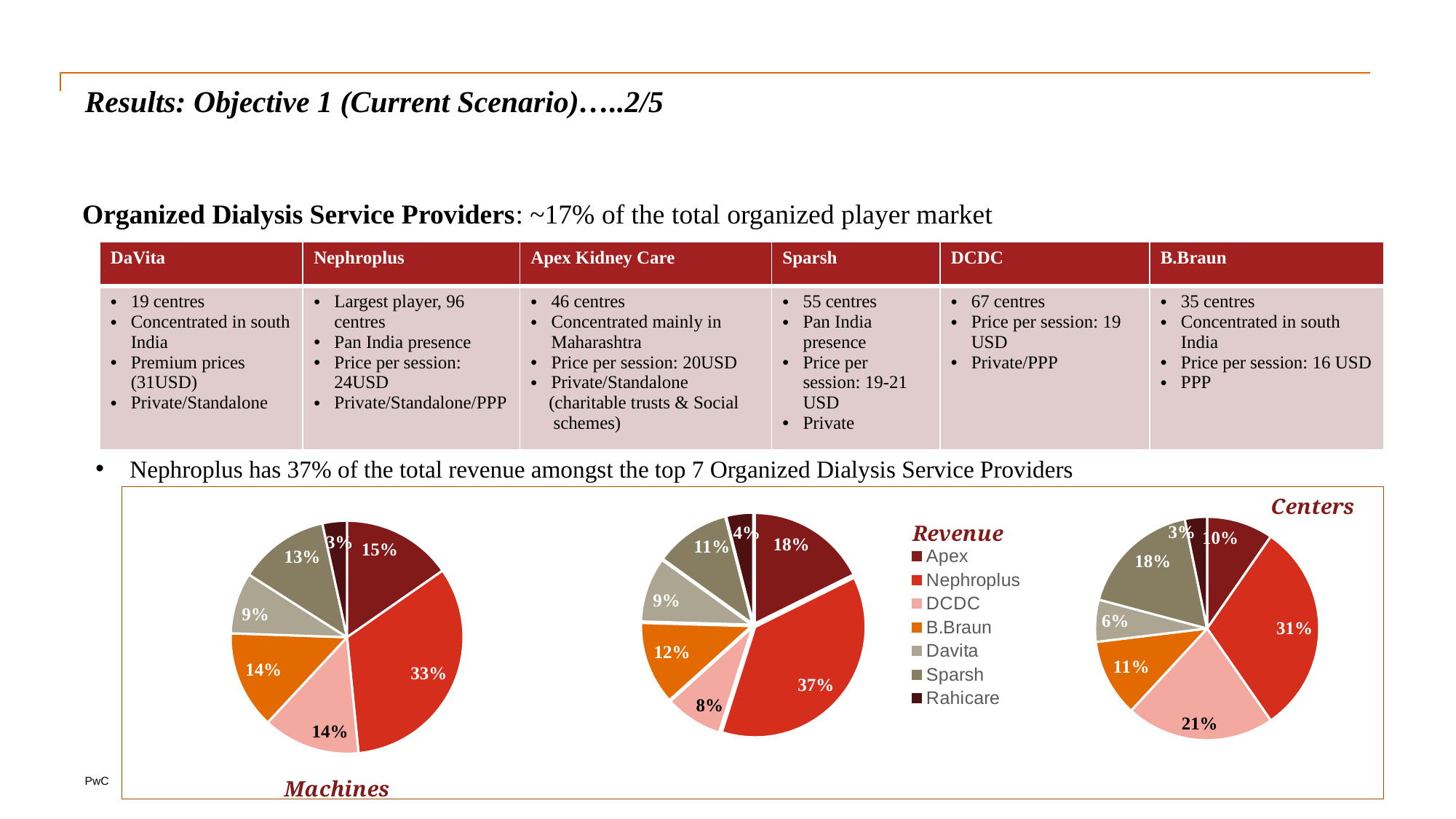
In the Revenue pie chart, what share does Nephroplus have? 37% In the Machines pie chart, what is the difference between the Nephroplus share and the Apex share? 18% In the Centers pie chart, which provider has the largest share? Nephroplus How many slices does the Revenue pie chart have? 7 In the Centers pie chart, what share does DCDC have? 21% In the Centers pie chart, which is larger, the share for Sparsh or the share for B.Braun? Sparsh How many entries does the legend list for the pie charts? 7 Which legend entry is shown in orange? B.Braun In the Revenue pie chart, which provider has the smallest share? Rahicare In the Revenue pie chart, what is the combined share of Apex and Nephroplus? 55% What type of chart is used for Machines, Revenue and Centers? Pie chart In the Machines pie chart, what share does Sparsh have? 13%